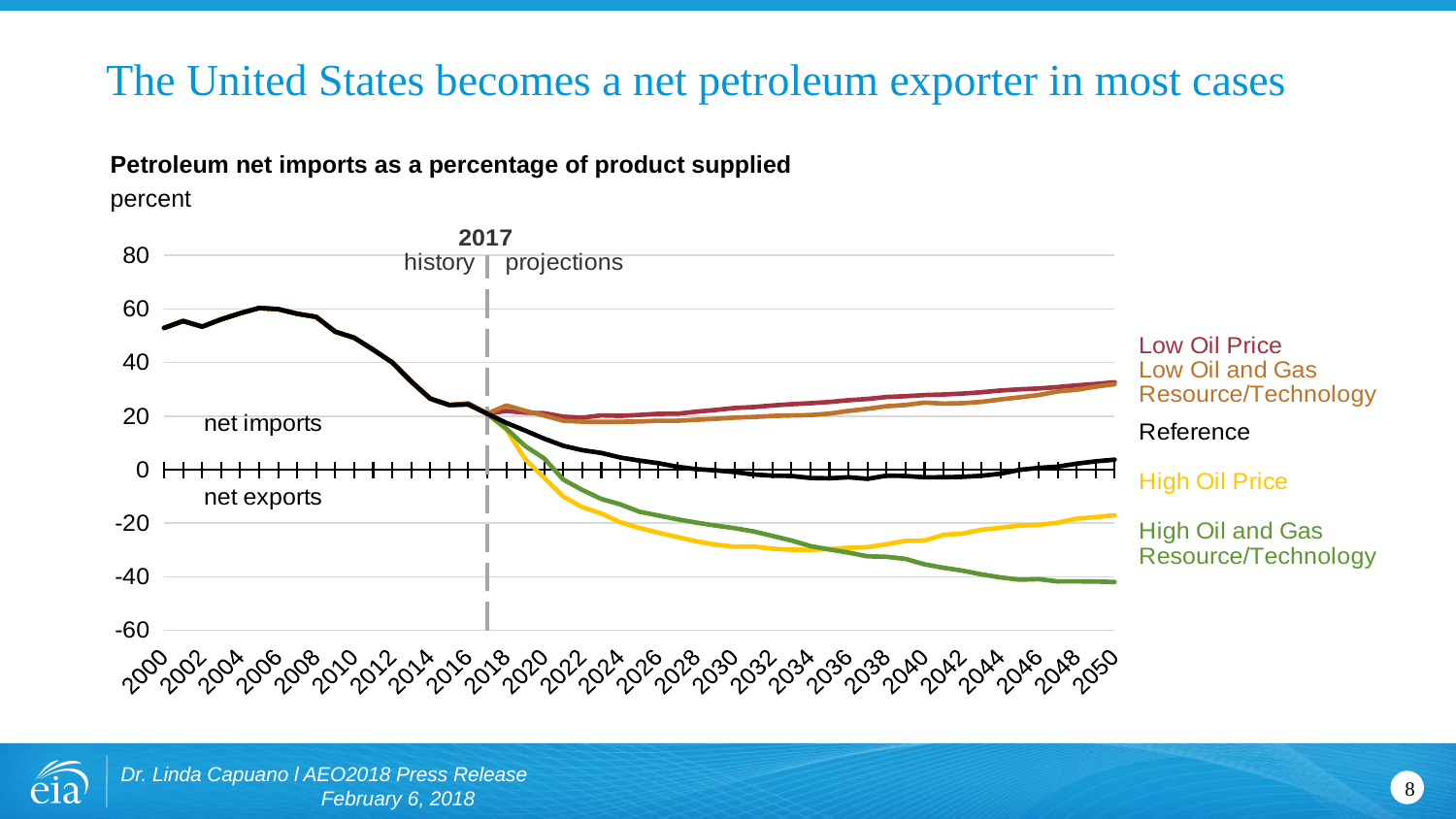
Does the Low Oil Price case rise or fall between 2022 and 2050? rise Which year separates history from projections on the chart? 2017 How many series (scenarios) are labelled on the chart? 5 Which scenario has the lowest value in 2050? High Oil and Gas Resource/Technology Is the value for the High Oil and Gas Resource/Technology case in 2050 greater or less than -20? less Is the value for the High Oil Price case in 2050 greater or less than -40? greater Does the Reference case rise or fall between 2017 and 2040? fall Which is larger in 2050, the Low Oil Price case or the High Oil Price case? Low Oil Price Is the value for the Low Oil Price case in 2050 greater or less than 20? greater What kind of chart is shown on the slide? line chart What is the title of the chart? Petroleum net imports as a percentage of product supplied